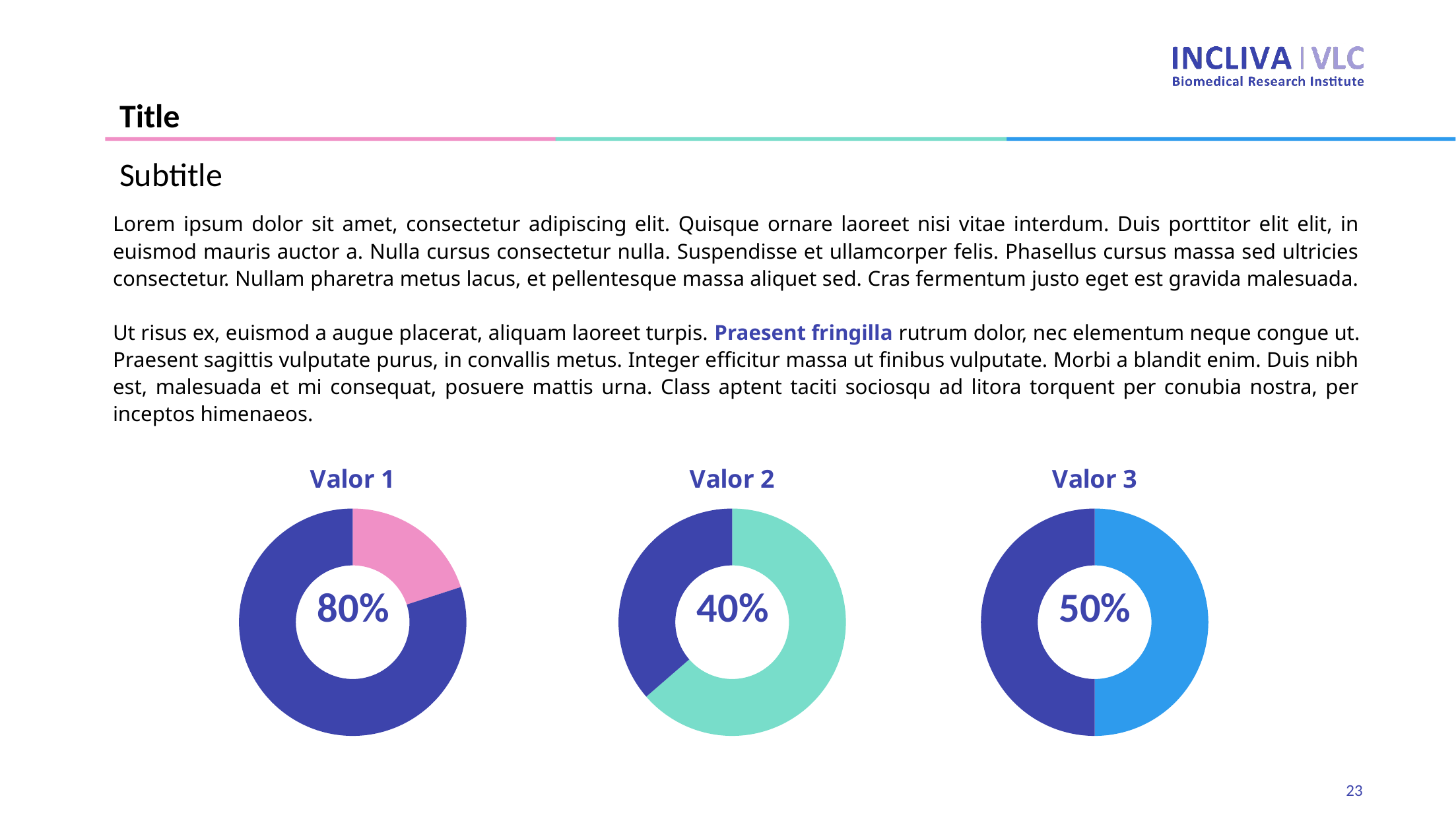
What kind of chart is used for Valor 1, Valor 2 and Valor 3? Donut chart What colour is the smaller slice of the Valor 1 donut chart? Pink What percentage is shown in the centre of the Valor 1 donut chart? 80% What is the difference between the percentage shown for Valor 3 and the percentage shown for Valor 2? 10% What is the difference between the percentage shown for Valor 1 and the percentage shown for Valor 2? 40% What percentage is shown in the centre of the Valor 3 donut chart? 50% Which of the three donut charts shows the lowest percentage? Valor 2 How many slices does the Valor 3 donut chart have? 2 What percentage is shown in the centre of the Valor 2 donut chart? 40% Which shows a larger percentage, Valor 1 or Valor 3? Valor 1 Which of the three donut charts shows the highest percentage? Valor 1 How many donut charts are shown on the slide? 3